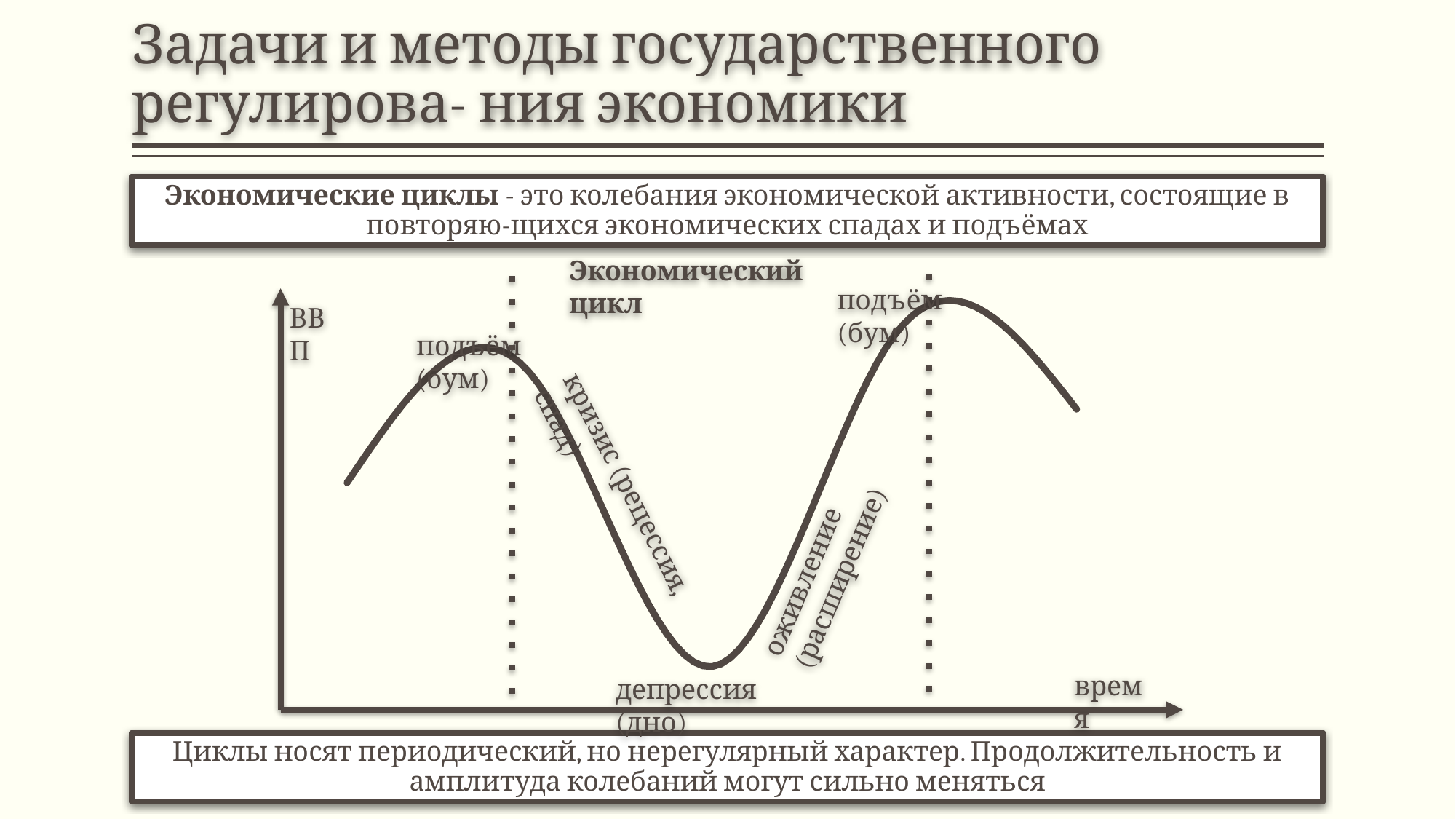
What kind of chart is shown on the slide? line chart What is the title of the diagram on the slide? Экономический цикл What label is on the horizontal axis of the diagram? время What phase of the cycle is labelled at the lowest point of the curve? депрессия (дно) Does the curve rise or fall during the phase labelled "оживление (расширение)"? rise Does the curve rise or fall between "подъём (бум)" and "депрессия (дно)"? fall What phase of the cycle is labelled at the peaks of the curve? подъём (бум) How many peaks labelled "подъём (бум)" does the curve have? 2 How many vertical dotted lines are drawn on the diagram? 2 Which phase is labelled on the falling part of the curve after the first peak? кризис (рецессия, спад) What label is on the vertical axis of the diagram? ВВП